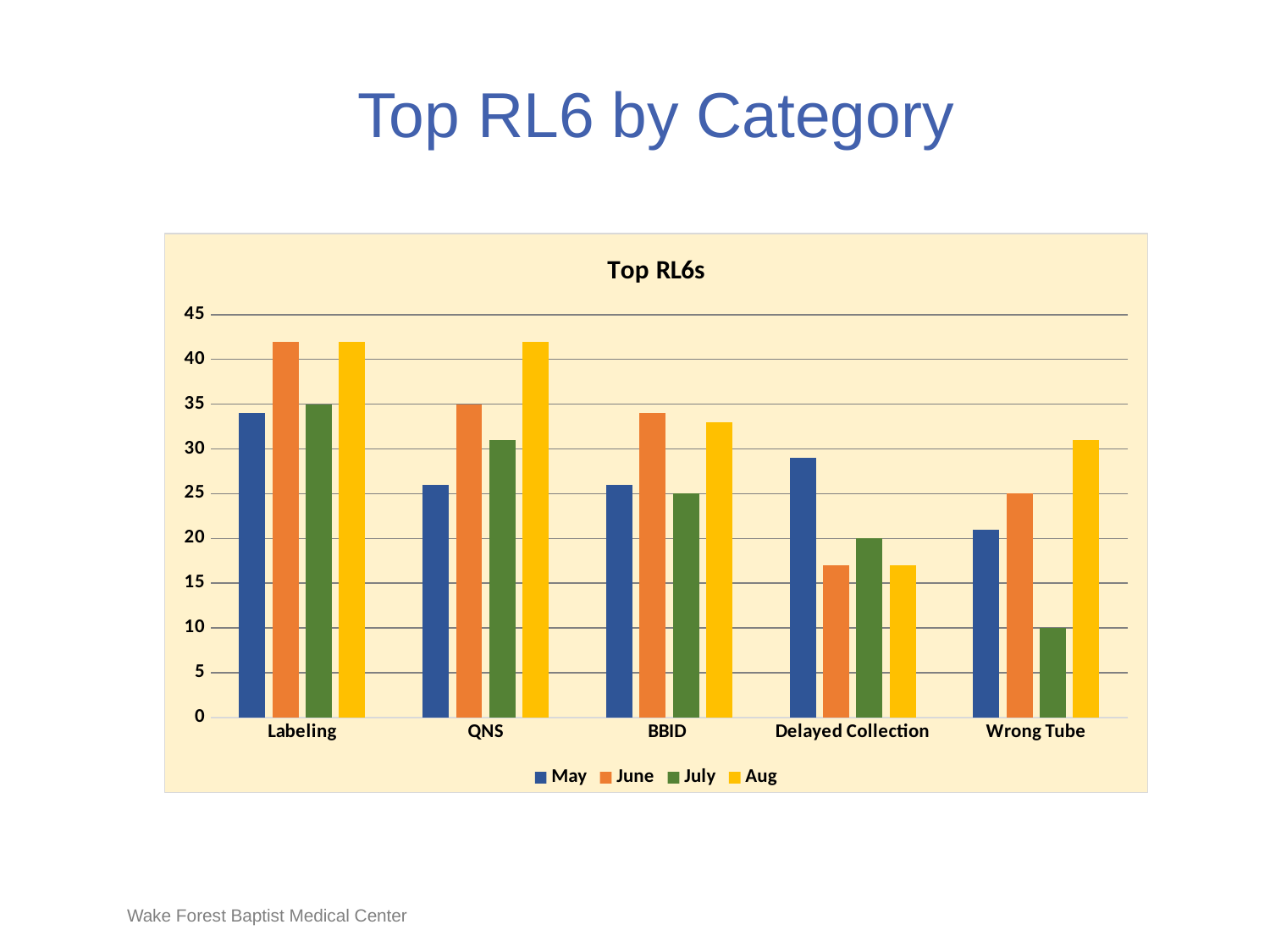
Which is larger, the May value for Labeling or the May value for Delayed Collection? Labeling What is the value for July in the Wrong Tube category? 10 How many categories are shown on the x axis? 5 Is the value for June in the Delayed Collection category greater or less than 20? less Is the value for May in the QNS category greater or less than 30? less Which category has the lowest bar in the chart? Wrong Tube What kind of chart is shown on the slide? bar chart What is the value for July in the Delayed Collection category? 20 Is the value for June in the Labeling category greater or less than 40? greater What is the title shown inside the chart? Top RL6s How many series does the legend list? 4